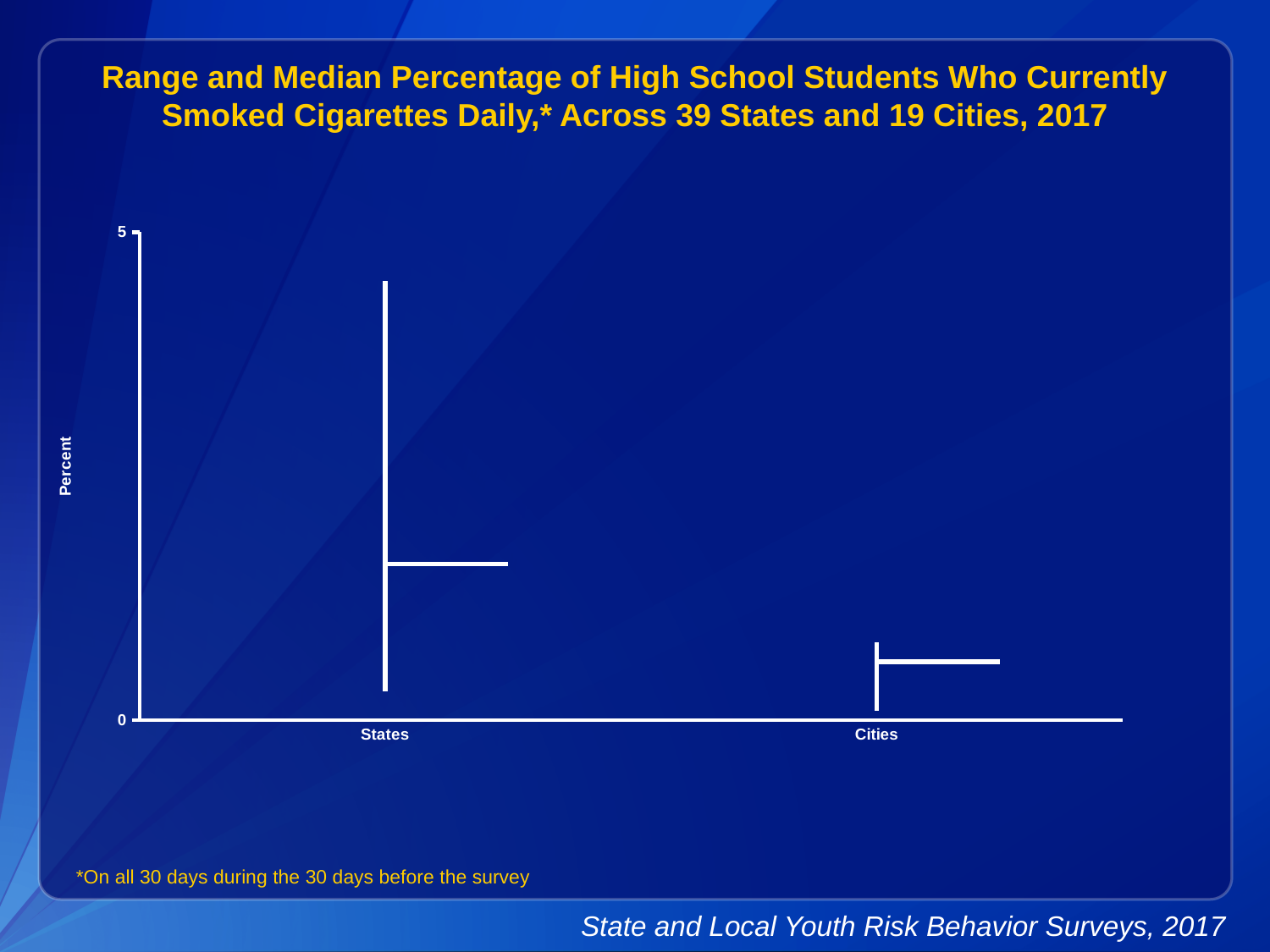
Is the median value for Cities greater or less than 5? less What is the maximum value shown on the y axis? 5 Which category shows the wider range of values? States What is the label on the y axis? Percent Which category shows the narrower range of values? Cities How many categories are shown on the x axis of the chart? 2 What year does the chart's data refer to? 2017 How many cities are covered by the data in the chart title? 19 Is the highest value in the States range greater or less than 5? less Which category has the higher median percentage, States or Cities? States How many states are covered by the data in the chart title? 39 What are the two categories shown on the x axis? States and Cities